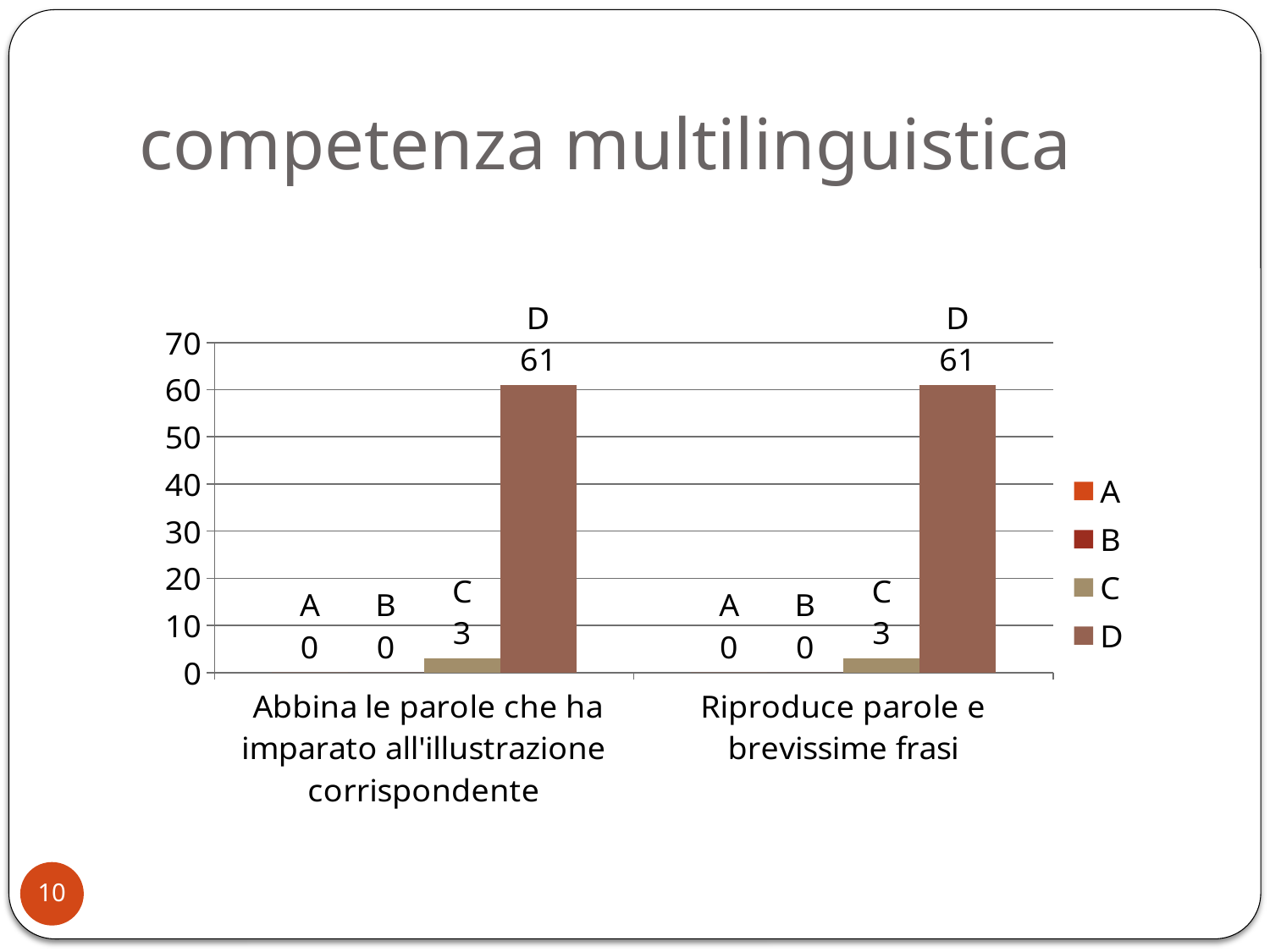
Is the value for series D in the category "Abbina le parole che ha imparato all'illustrazione corrispondente" greater or less than 50? greater What kind of chart is shown on the slide? bar chart What is the title of the slide containing the chart? competenza multilinguistica What is the value for series B in the category "Abbina le parole che ha imparato all'illustrazione corrispondente"? 0 What is the value for series D in the category "Abbina le parole che ha imparato all'illustrazione corrispondente"? 61 How many series does the legend list? 4 Which series has the highest value in the category "Riproduce parole e brevissime frasi"? D Which is larger in the category "Riproduce parole e brevissime frasi": the value for series C or the value for series D? D How many categories are shown on the x axis of the chart? 2 What is the value for series A in the category "Riproduce parole e brevissime frasi"? 0 What is the value for series C in the category "Riproduce parole e brevissime frasi"? 3 What is the difference between the values for series D and series C in the category "Abbina le parole che ha imparato all'illustrazione corrispondente"? 58